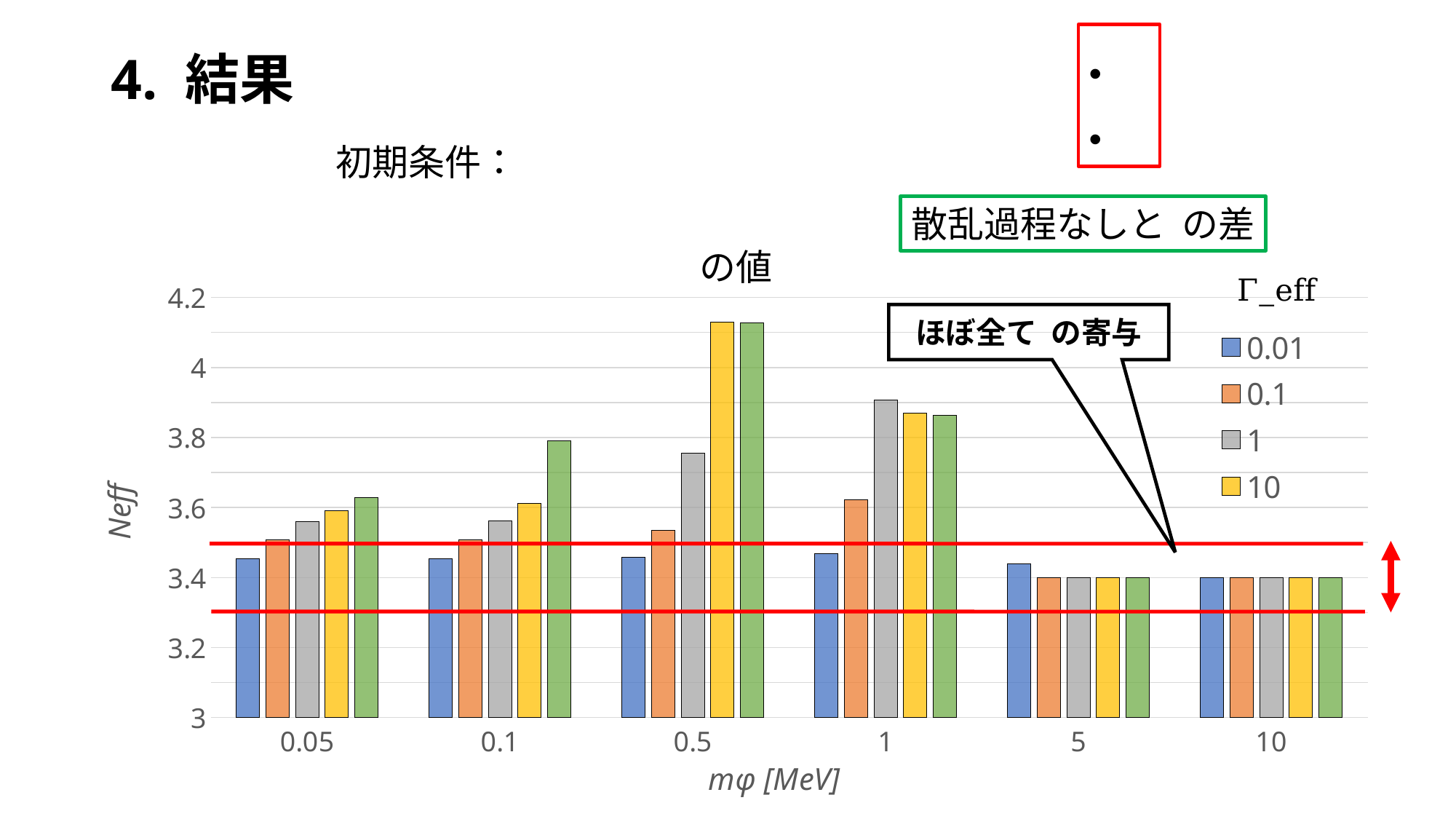
How many bars are plotted for each mφ category? 5 Is the value of the blue (Γ_eff = 0.01) bar at mφ = 0.05 greater or less than 3.6? less What is the label of the y axis? Neff What is the label of the x axis? mφ [MeV] What kind of chart is shown on the slide? bar chart Which is larger: the gray (Γ_eff = 1) bar at mφ = 0.5 or the gray bar at mφ = 1? mφ = 1 Is the value of the gray (Γ_eff = 1) bar at mφ = 1 greater or less than 3.8? greater How many mφ categories are shown on the x axis? 6 Which mφ category contains the tallest bar in the chart? 0.5 Is the value of the yellow (Γ_eff = 10) bar at mφ = 0.5 greater or less than 4? greater Which series has the tallest bar at mφ = 0.1? green